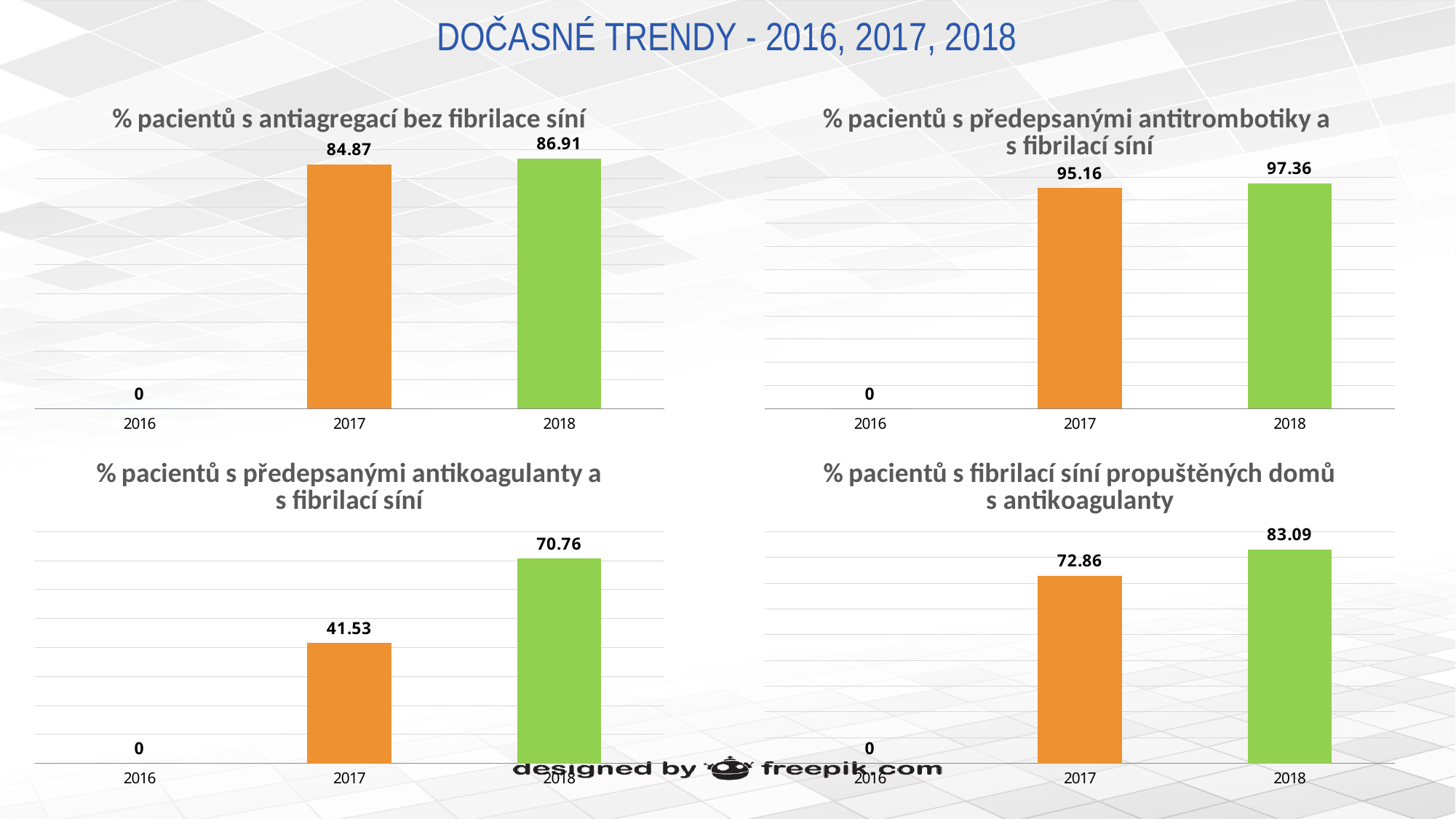
In the top-right chart (% pacientů s předepsanými antitrombotiky a s fibrilací síní), which year has the lowest value? 2016 In the bottom-right chart (% pacientů s fibrilací síní propuštěných domů s antikoagulanty), what is the value for 2016? 0 In the top-left chart (% pacientů s antiagregací bez fibrilace síní), what is the value for 2017? 84.87 In the bottom-right chart (% pacientů s fibrilací síní propuštěných domů s antikoagulanty), what is the difference between the 2018 and 2017 values? 10.23 What kind of chart is the bottom-right chart (% pacientů s fibrilací síní propuštěných domů s antikoagulanty)? Bar chart In the top-right chart (% pacientů s předepsanými antitrombotiky a s fibrilací síní), what is the value for 2018? 97.36 In the top-left chart (% pacientů s antiagregací bez fibrilace síní), which is larger, the value for 2017 or for 2018? 2018 How many years (categories) are shown on the x axis of the top-left chart (% pacientů s antiagregací bez fibrilace síní)? 3 In the bottom-left chart (% pacientů s předepsanými antikoagulanty a s fibrilací síní), what is the value for 2017? 41.53 In the bottom-left chart (% pacientů s předepsanými antikoagulanty a s fibrilací síní), which year has the highest value? 2018 In the bottom-right chart (% pacientů s fibrilací síní propuštěných domů s antikoagulanty), do the values rise or fall from 2016 to 2018? Rise In the bottom-left chart (% pacientů s předepsanými antikoagulanty a s fibrilací síní), what is the difference between the 2018 and 2017 values? 29.23